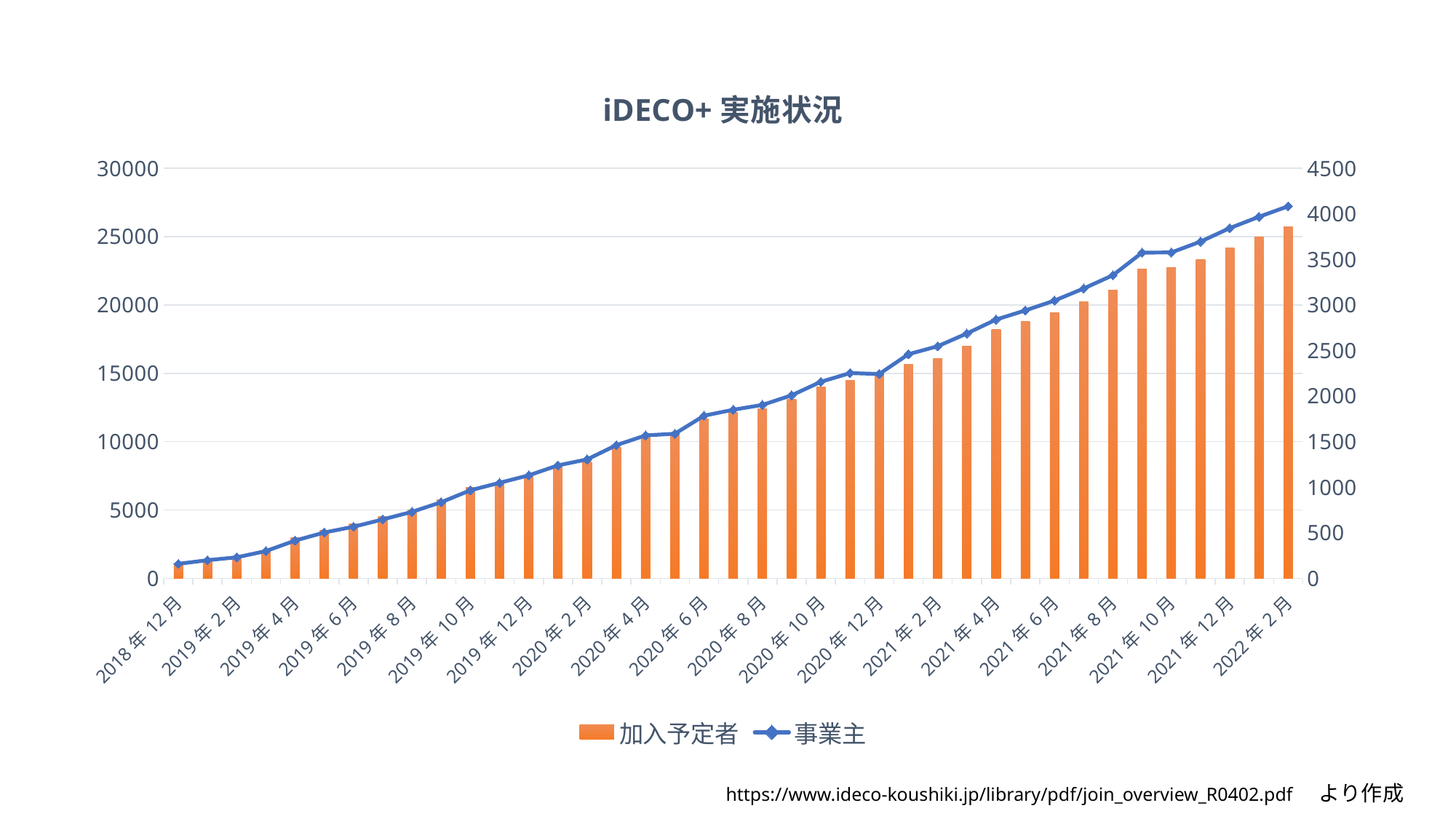
What kind of chart is this? Combination bar and line chart Which month has the highest value for 加入予定者? 2022年2月 Is the value for 事業主 in 2022年2月 greater or less than 3500 on the right axis? greater Is the value for 加入予定者 in 2022年2月 greater or less than 20000? greater How many series does the legend list? 2 Which is larger for 加入予定者: 2021年10月 or 2019年10月? 2021年10月 What is the title of the chart? iDECO+ 実施状況 Which month has the lowest value for 加入予定者? 2018年12月 Do the values for 事業主 rise or fall from 2018年12月 to 2022年2月? rise Is the value for 加入予定者 in 2018年12月 greater or less than 5000? less Which series is drawn as bars? 加入予定者